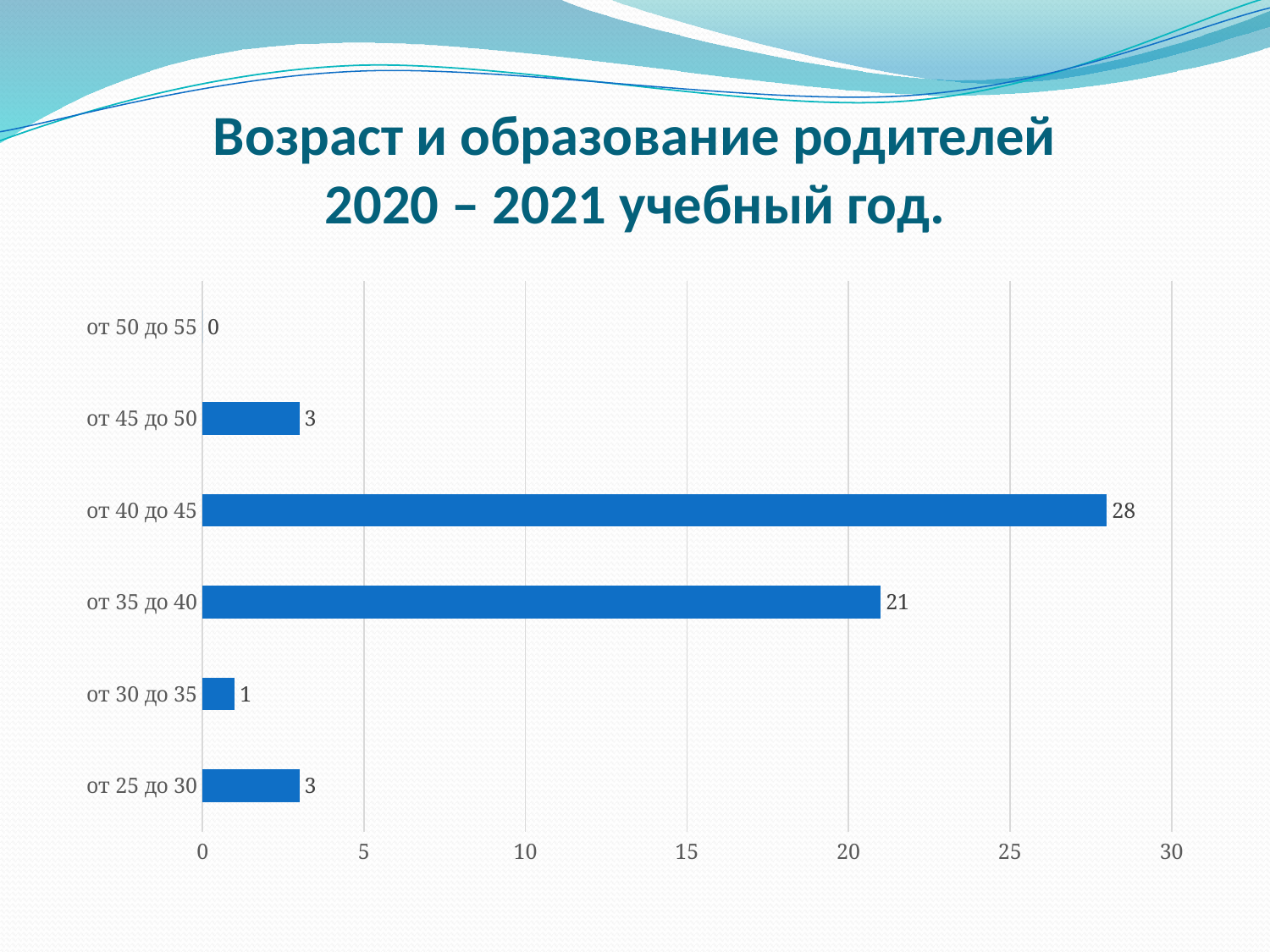
What is the title of the slide? Возраст и образование родителей 2020 – 2021 учебный год. What is the value for the category "от 40 до 45"? 28 Which is larger, the value for "от 45 до 50" or the value for "от 30 до 35"? от 45 до 50 What is the difference between the values for "от 40 до 45" and "от 35 до 40"? 7 What is the value for the category "от 30 до 35"? 1 How many categories are shown on the chart? 6 What is the value for the category "от 35 до 40"? 21 What is the value for the category "от 50 до 55"? 0 Which category has the highest value? от 40 до 45 Which category has the lowest value? от 50 до 55 Is the value for "от 35 до 40" greater or less than 20? greater What kind of chart is shown on the slide? bar chart